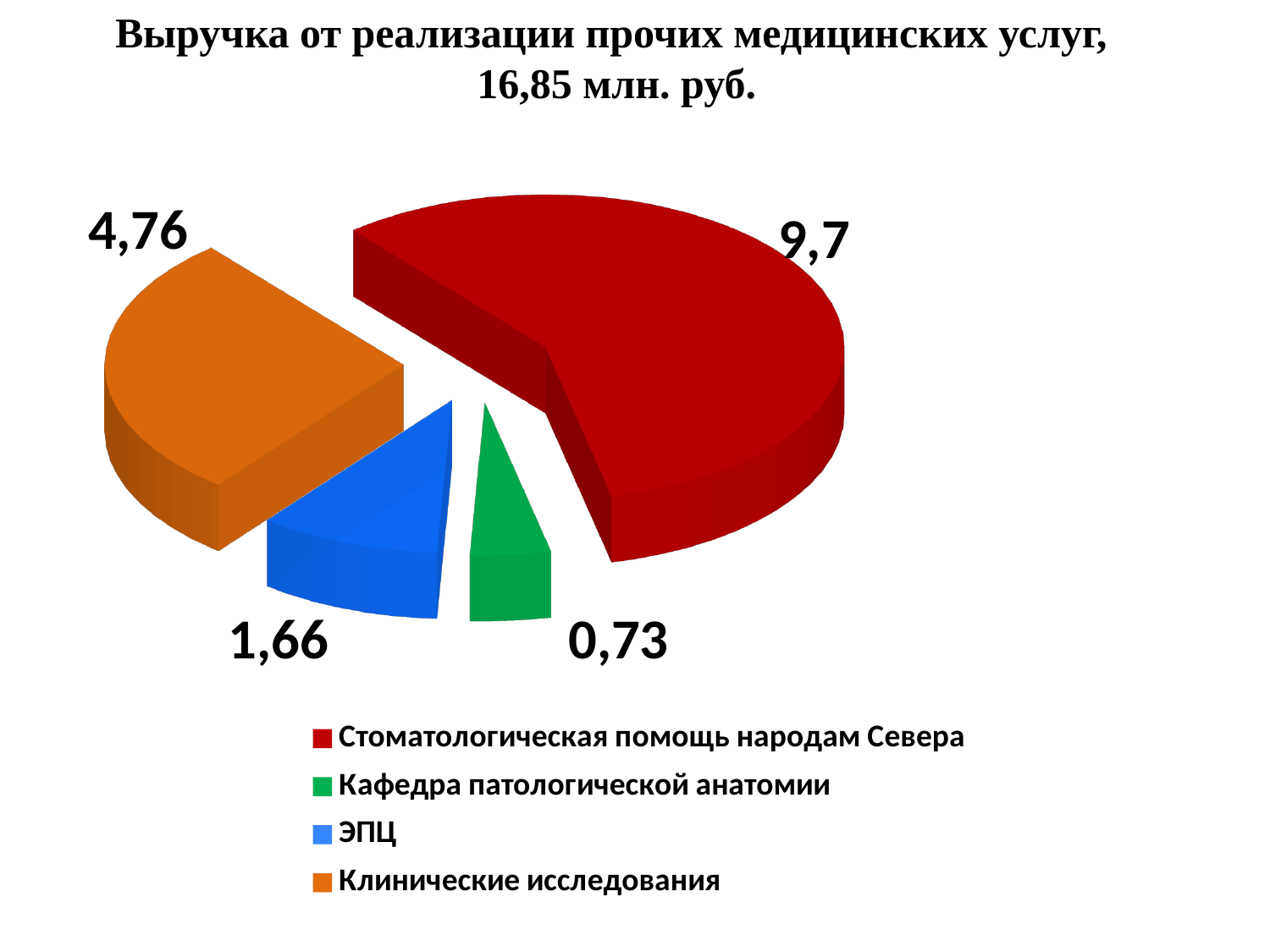
What is the value for Стоматологическая помощь народам Севера? 9,7 What is the difference between the values for ЭПЦ and Кафедра патологической анатомии? 0,93 Which category has the smallest slice of the pie? Кафедра патологической анатомии Which category has the largest slice of the pie? Стоматологическая помощь народам Севера What is the value for ЭПЦ? 1,66 How many categories does the legend list? 4 What type of chart is shown on the slide? Pie chart Which is larger, the value for ЭПЦ or the value for Клинические исследования? Клинические исследования What total revenue is stated in the chart title? 16,85 млн. руб. What is the value for Клинические исследования? 4,76 What is the value for Кафедра патологической анатомии? 0,73 What is the difference between the values for Стоматологическая помощь народам Севера and Клинические исследования? 4,94